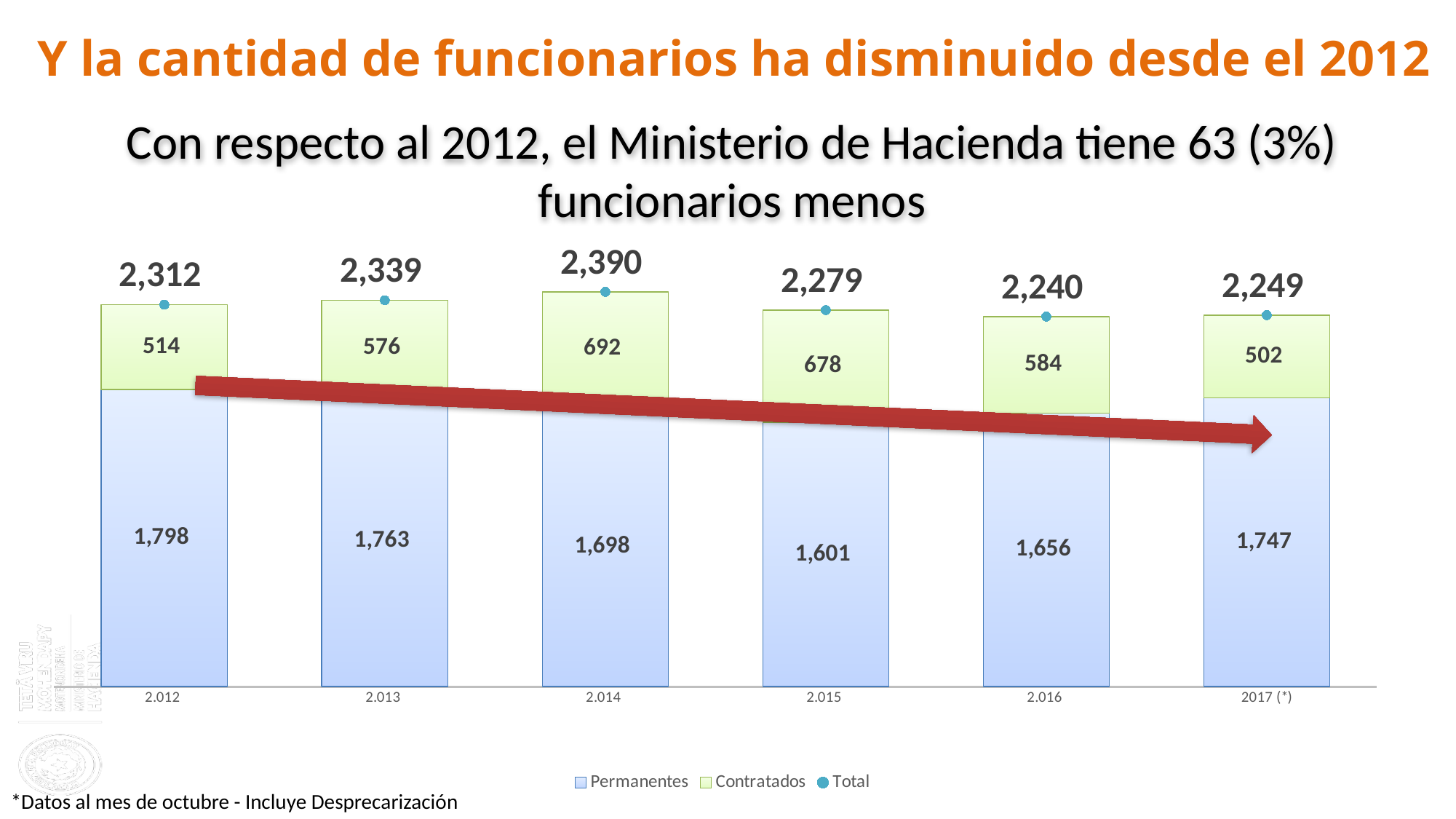
What is the difference between the Total for 2.012 and the Total for 2017 (*)? 63 What is the value for Permanentes in 2.012? 1,798 Which year has the highest Total? 2.014 Which is larger, Contratados in 2.013 or Contratados in 2.016? 2.016 Which year has the lowest Permanentes value? 2.015 What is the Total for 2017 (*)? 2,249 What are the three entries listed in the legend? Permanentes, Contratados, Total What is the total of the stacked bar for 2.015 (Permanentes plus Contratados)? 2,279 What is the value for Contratados in 2.014? 692 How many series does the legend list? 3 How many years are shown on the x axis? 6 What kind of chart is shown on the slide? Stacked bar chart